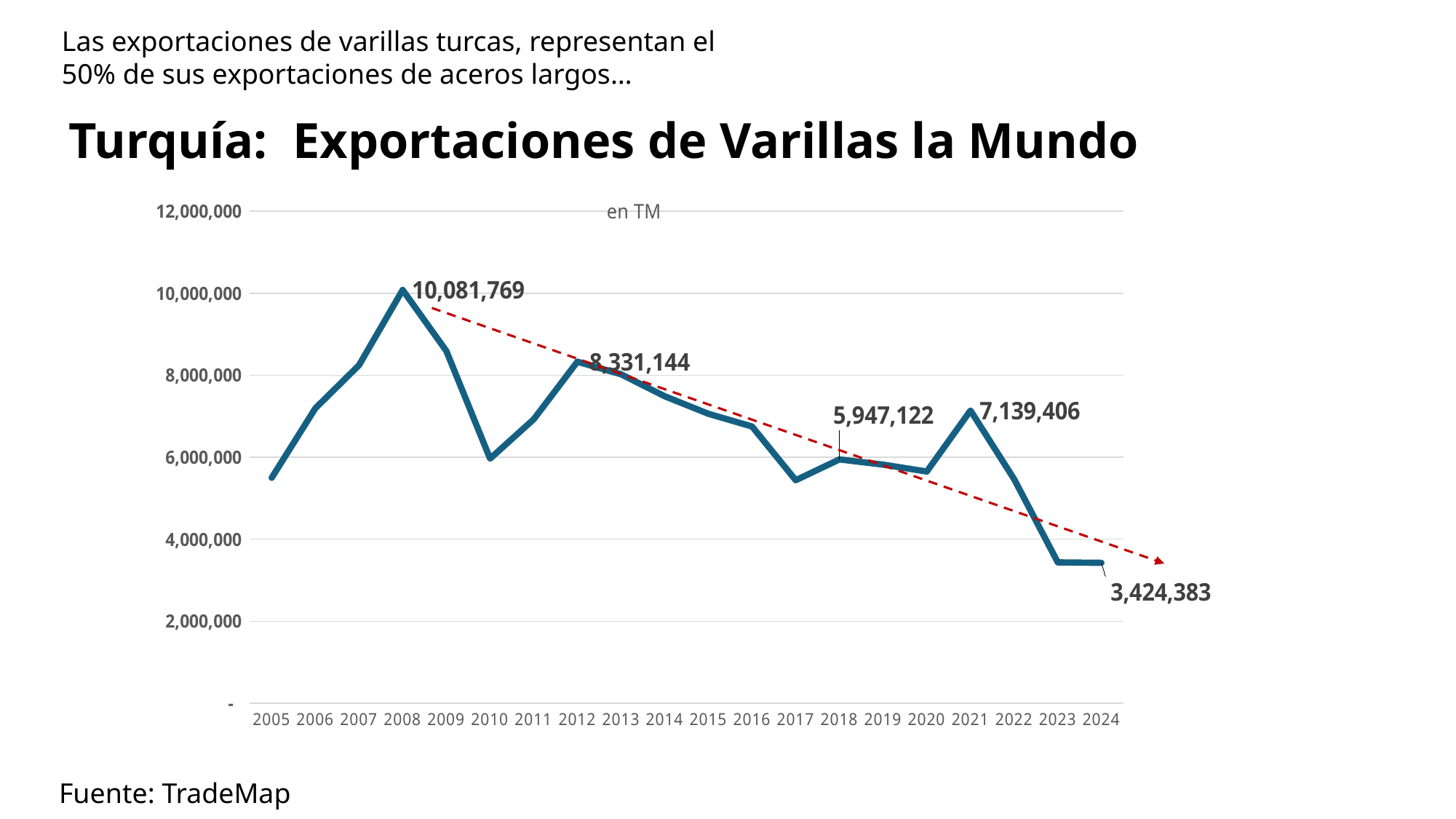
How many years are plotted on the x axis? 20 Which is larger, the value for 2012 or the value for 2021? 2012 What is the value for 2018? 5,947,122 Which year has the highest value? 2008 Is the value for 2005 greater or less than 6,000,000? less What is the value for 2012? 8,331,144 What is the difference between the values for 2021 and 2018? 1,192,284 What is the value for 2024? 3,424,383 What is the value for 2021? 7,139,406 What is the difference between the values for 2008 and 2024? 6,657,386 What kind of chart is shown? line chart What is the value for 2008? 10,081,769